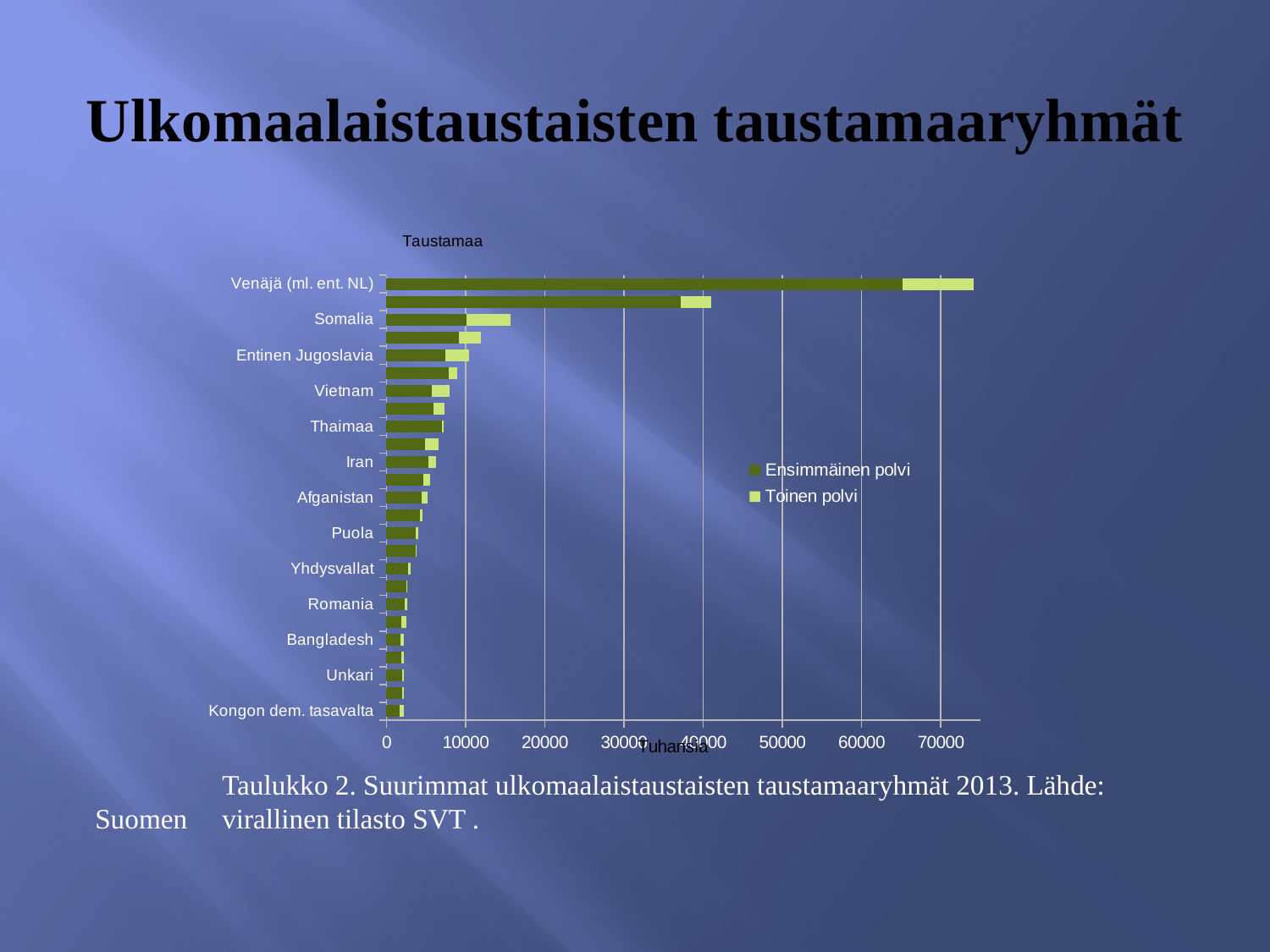
Is the total bar for Venäjä (ml. ent. NL) greater or less than 70000? greater What are the two series named in the legend? Ensimmäinen polvi and Toinen polvi Which has a longer bar, Venäjä (ml. ent. NL) or Somalia? Venäjä (ml. ent. NL) Is the total bar for Iran greater or less than 10000? less Which labelled background country has the shortest bar? Kongon dem. tasavalta What kind of chart is shown on the slide? bar chart Is the Ensimmäinen polvi value for Venäjä (ml. ent. NL) greater or less than 60000? greater How many series does the legend list? 2 Which background country has the longest bar? Venäjä (ml. ent. NL) What is the title shown above the category axis of the chart? Taustamaa Do the bar lengths increase or decrease going from the top of the chart to the bottom? decrease